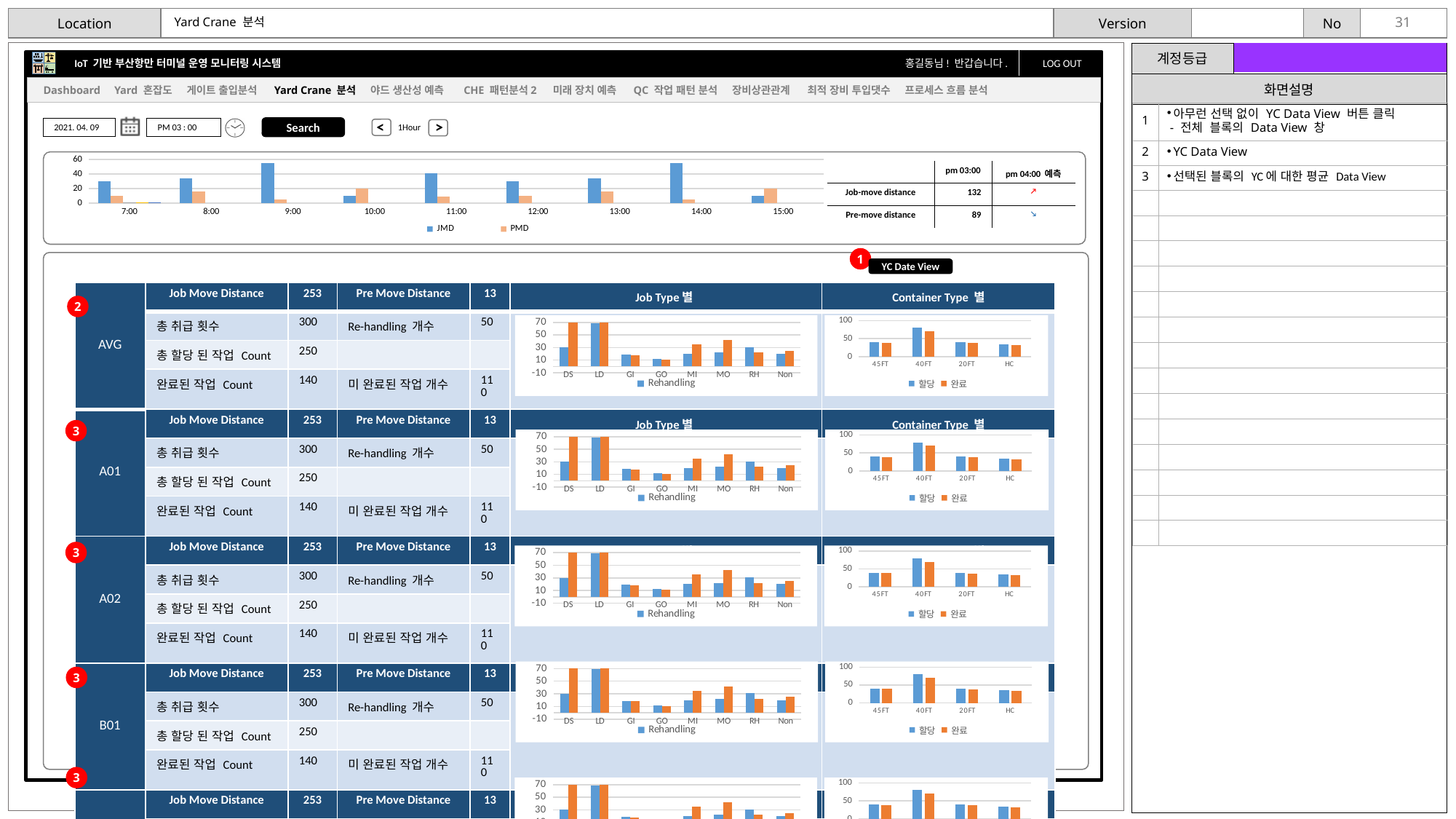
In the AVG row's 'Container Type 별' chart, what are the two legend entries? 할당, 완료 In the AVG row's 'Job Type 별' chart, is the blue bar for DS greater or less than 50? less In the AVG row's 'Job Type 별' chart, how many job type categories are on the x axis? 8 How many time categories are shown on the x axis of the top JMD/PMD chart? 9 In the top JMD/PMD chart, is the JMD value at 10:00 greater or less than 20? less In the top JMD/PMD chart, which series has the larger value at 7:00, JMD or PMD? JMD How many series does the legend of the top JMD/PMD chart list? 2 In the top JMD/PMD chart, is the JMD value at 9:00 greater or less than 40? greater In the top JMD/PMD chart, which series has the larger value at 15:00, JMD or PMD? PMD In the AVG row's 'Container Type 별' chart, which category has the highest bars? 40FT In the AVG row's 'Job Type 별' chart, which category has the lowest bars? GO What type of chart is the top chart showing JMD and PMD by hour? bar chart